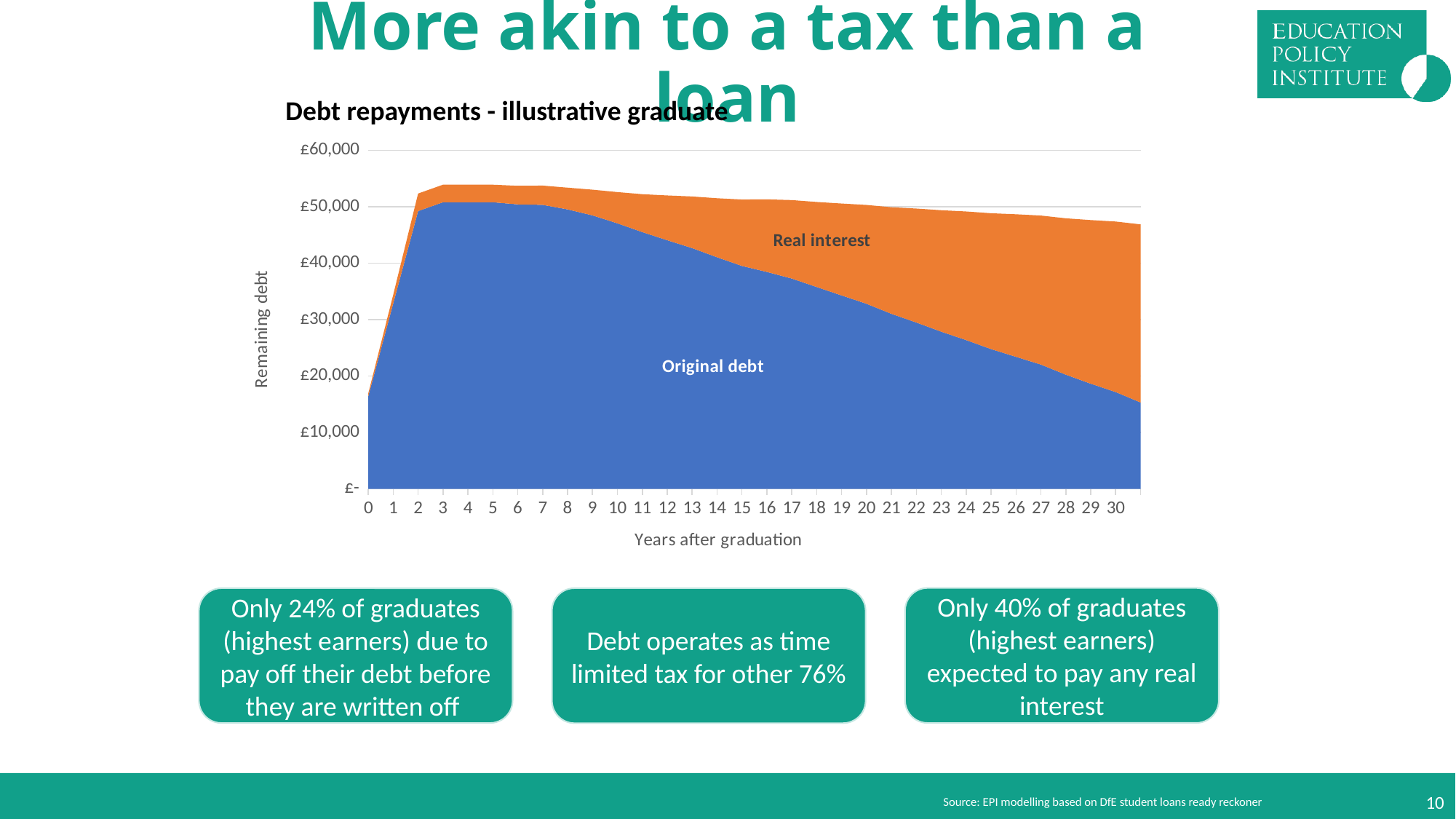
How many years after graduation are plotted on the x axis (from 0 to 30)? 31 What are the names of the two series shown in the chart? Original debt and Real interest Is the value of Original debt at year 20 greater or less than £30,000? greater What kind of chart is shown on the slide? Area chart Is the total remaining debt (Original debt plus Real interest) at year 3 greater or less than £50,000? greater Is the total remaining debt at year 30 greater or less than £50,000? less What is the title of the chart? Debt repayments - illustrative graduate How many series are plotted in the chart? 2 Does the Original debt rise or fall between year 0 and year 2? rise Does the Original debt rise or fall between year 3 and year 30? fall